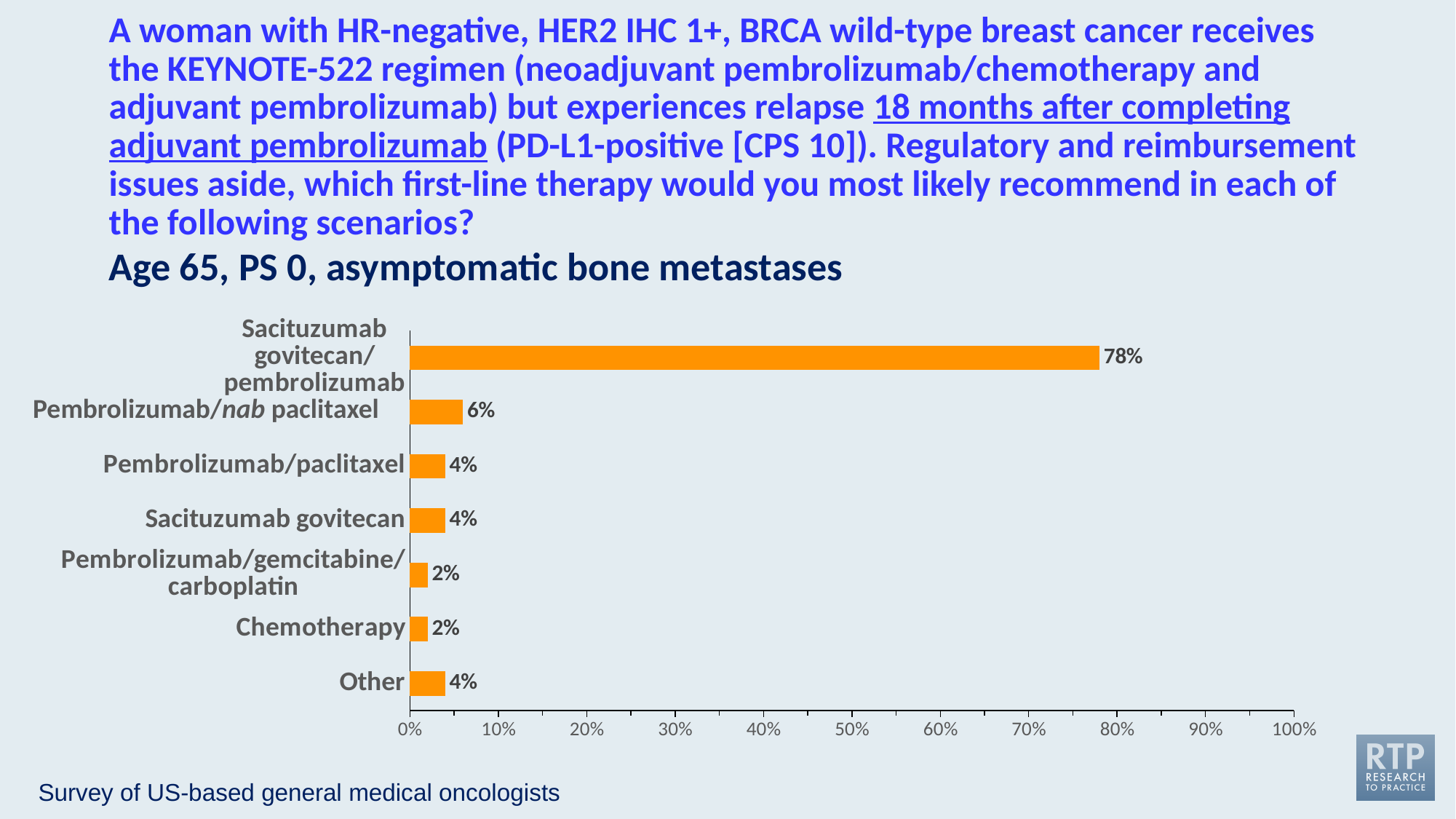
What scenario does the chart describe, according to the subtitle above it? Age 65, PS 0, asymptomatic bone metastases How many therapy options are shown in the chart? 7 What percentage of respondents would recommend chemotherapy? 2% What percentage of respondents would recommend sacituzumab govitecan/pembrolizumab? 78% Is the value for sacituzumab govitecan/pembrolizumab greater or less than 70%? greater What percentage of respondents chose 'Other'? 4% What type of chart is shown on the slide? Bar chart Which received a higher percentage: pembrolizumab/nab paclitaxel or pembrolizumab/paclitaxel? Pembrolizumab/nab paclitaxel Which therapy option received the highest percentage of responses? Sacituzumab govitecan/pembrolizumab What is the maximum value shown on the x axis? 100% What percentage of respondents would recommend pembrolizumab/nab paclitaxel? 6% What is the difference in percentage points between sacituzumab govitecan/pembrolizumab and pembrolizumab/nab paclitaxel? 72